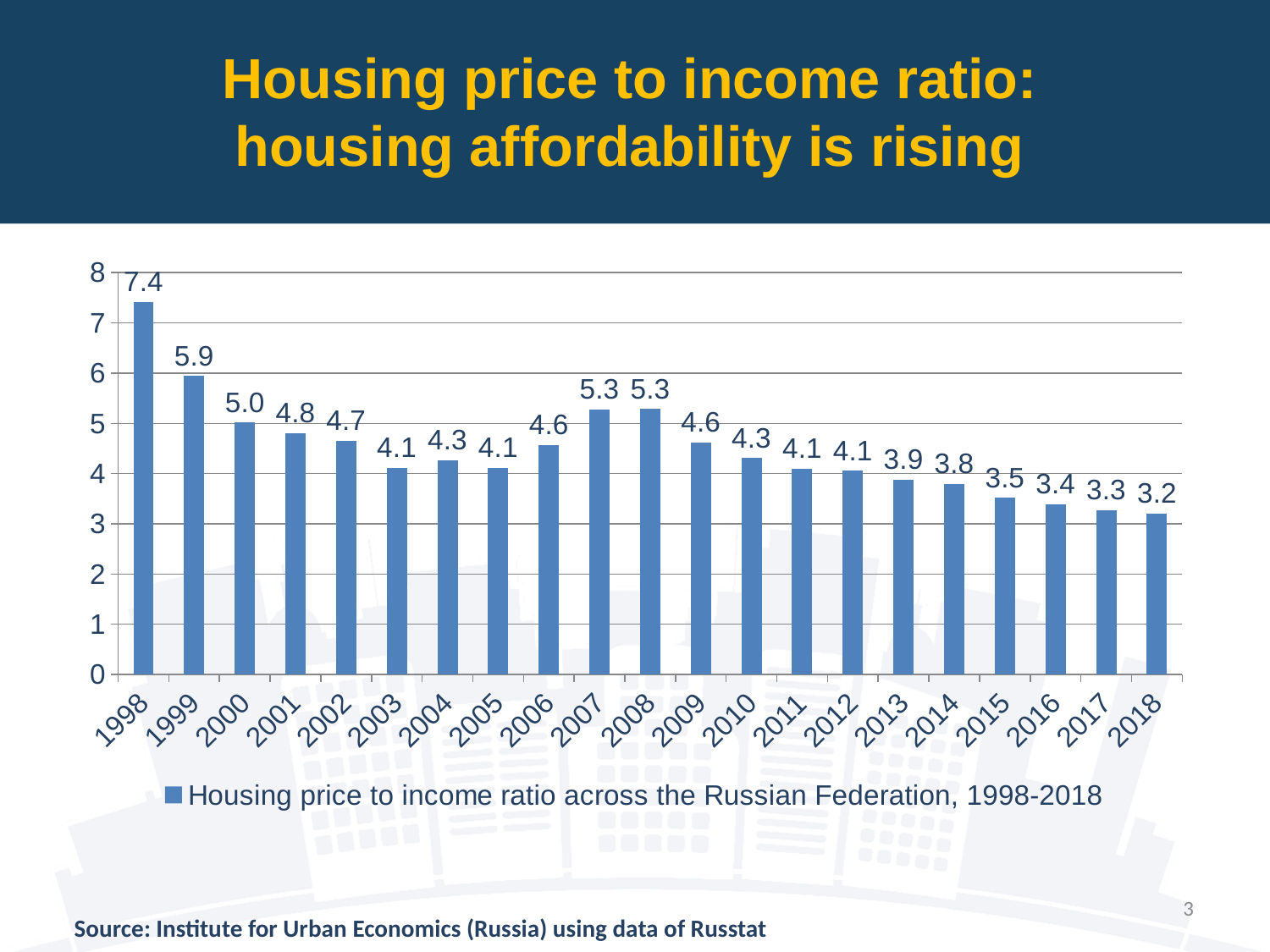
What is the legend entry for the series shown in the chart? Housing price to income ratio across the Russian Federation, 1998-2018 Which year has the lowest housing price to income ratio? 2018 How many years are shown on the x axis? 21 Which year has a higher housing price to income ratio, 1999 or 2009? 1999 What is the housing price to income ratio for 2018? 3.2 What is the difference between the housing price to income ratio in 1998 and in 2018? 4.2 What is the housing price to income ratio for 1998? 7.4 What is the housing price to income ratio for 2007? 5.3 Does the housing price to income ratio generally rise or fall from 2008 to 2018? Fall Is the value for 2013 greater or less than 4? less What kind of chart is shown on the slide? Bar chart Which year has the highest housing price to income ratio? 1998